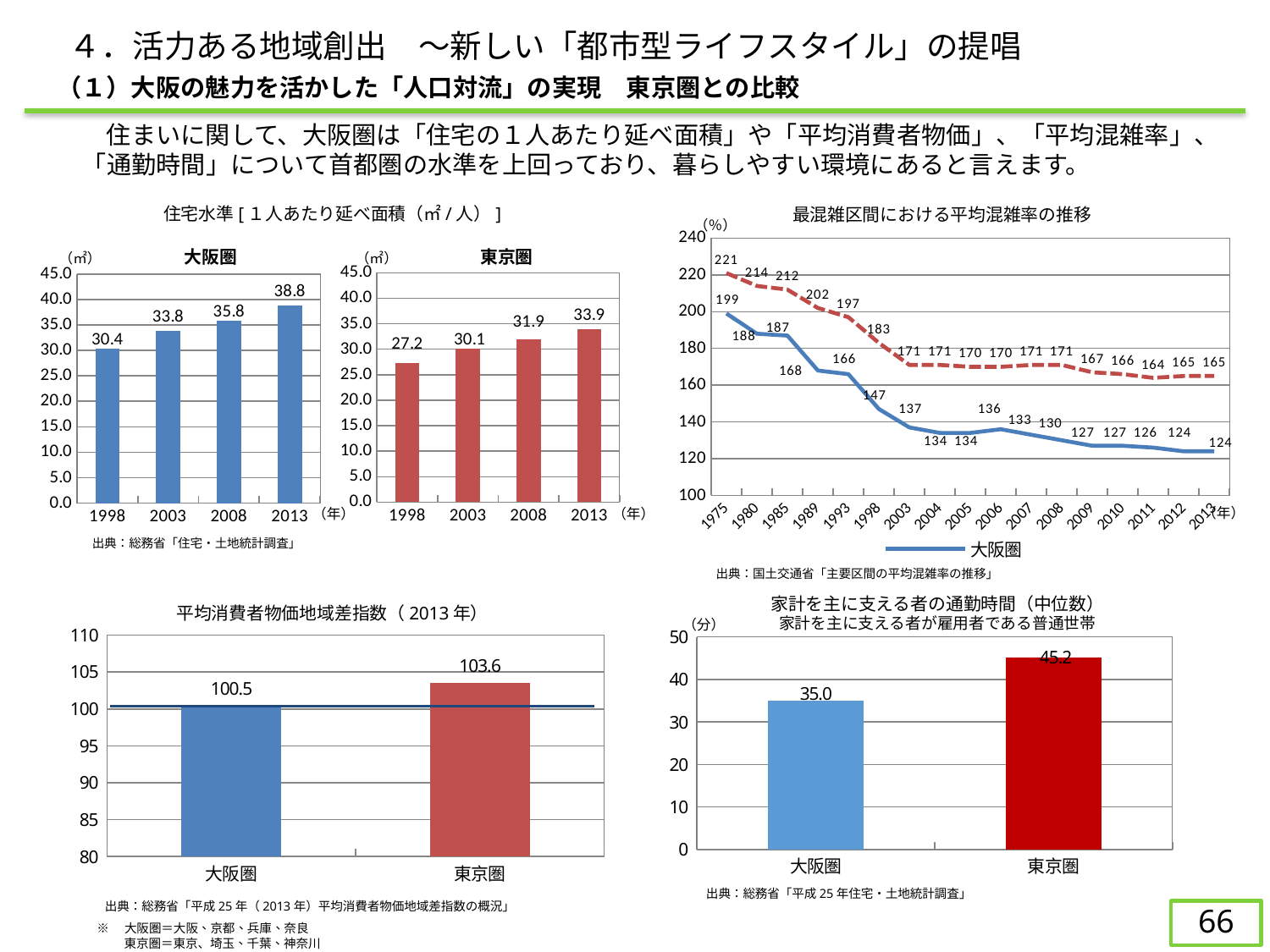
In the 通勤時間 chart at the bottom right, what is the value for 大阪圏? 35.0 In the 通勤時間 chart at the bottom right, what is the difference between 東京圏 and 大阪圏? 10.2 In the 住宅水準 chart for 大阪圏, do the values rise or fall from 1998 to 2013? rise In the 最混雑区間における平均混雑率の推移 chart, what is the value for 大阪圏 in 2013? 124 In the 住宅水準 chart for 東京圏, what is the value for 1998? 27.2 In the 住宅水準 chart for 大阪圏, what is the value for 2013? 38.8 In the 住宅水準 chart for 大阪圏, what is the difference between the 2013 and 1998 values? 8.4 In the 平均消費者物価地域差指数 chart, what is the value for 東京圏? 103.6 In the 最混雑区間における平均混雑率の推移 chart, what is the highest value shown on the dashed line? 221 In the 最混雑区間における平均混雑率の推移 chart, what is the value for 大阪圏 in 1975? 199 In the 住宅水準 chart for 東京圏, which year has the highest value? 2013 In the 平均消費者物価地域差指数 chart, which region has the lower value? 大阪圏